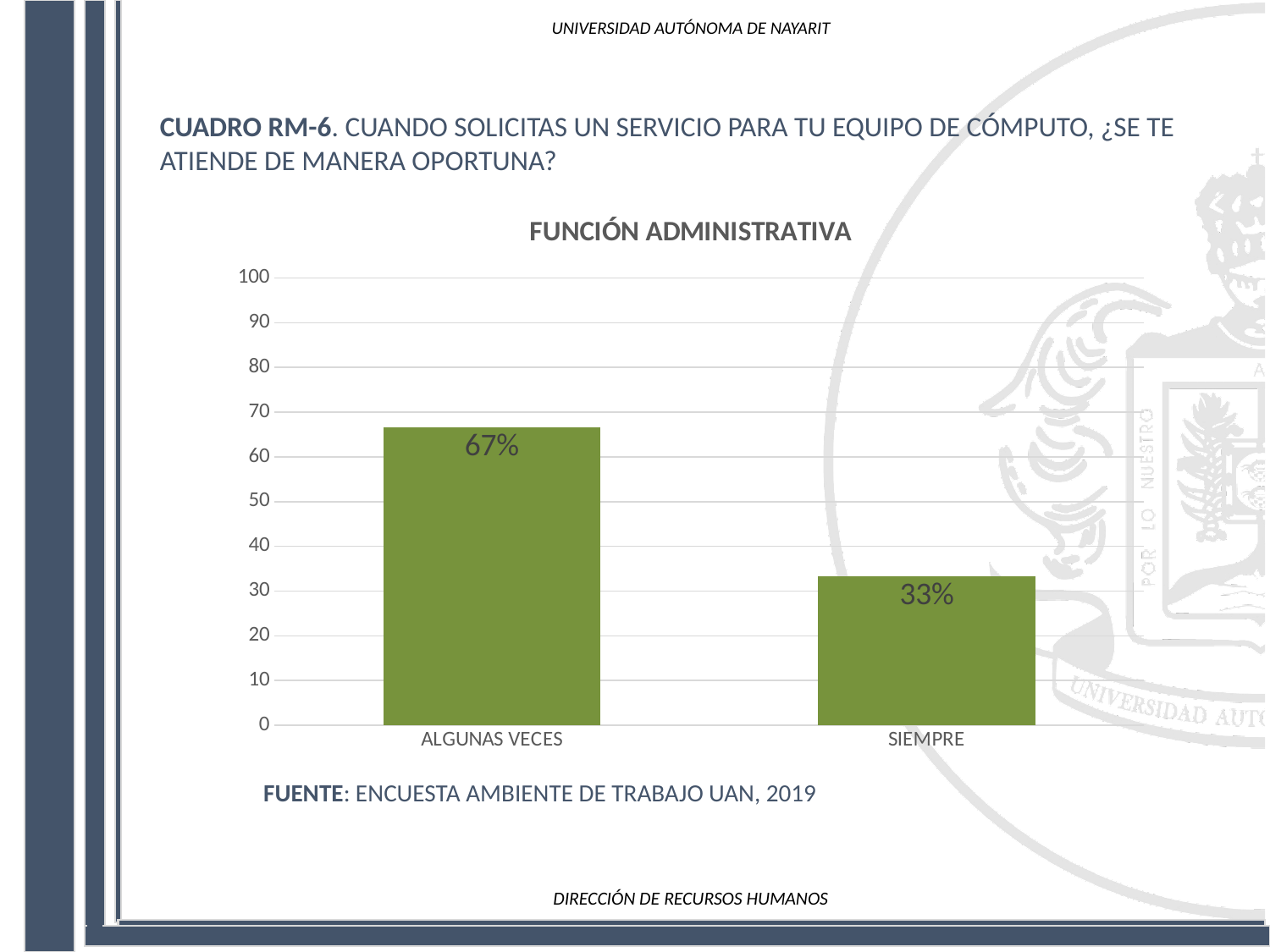
What kind of chart is shown on the slide? bar chart Which is larger, the value for ALGUNAS VECES or the value for SIEMPRE? ALGUNAS VECES What is the value for SIEMPRE? 33% Is the value for ALGUNAS VECES greater or less than 60? greater What is the highest value shown on the vertical axis? 100 What is the title of the chart? FUNCIÓN ADMINISTRATIVA Which category has the lowest value? SIEMPRE What is the value for ALGUNAS VECES? 67% Is the value for SIEMPRE greater or less than 40? less What is the difference between the values for ALGUNAS VECES and SIEMPRE? 34% Which category has the highest value? ALGUNAS VECES How many categories are shown on the x axis? 2